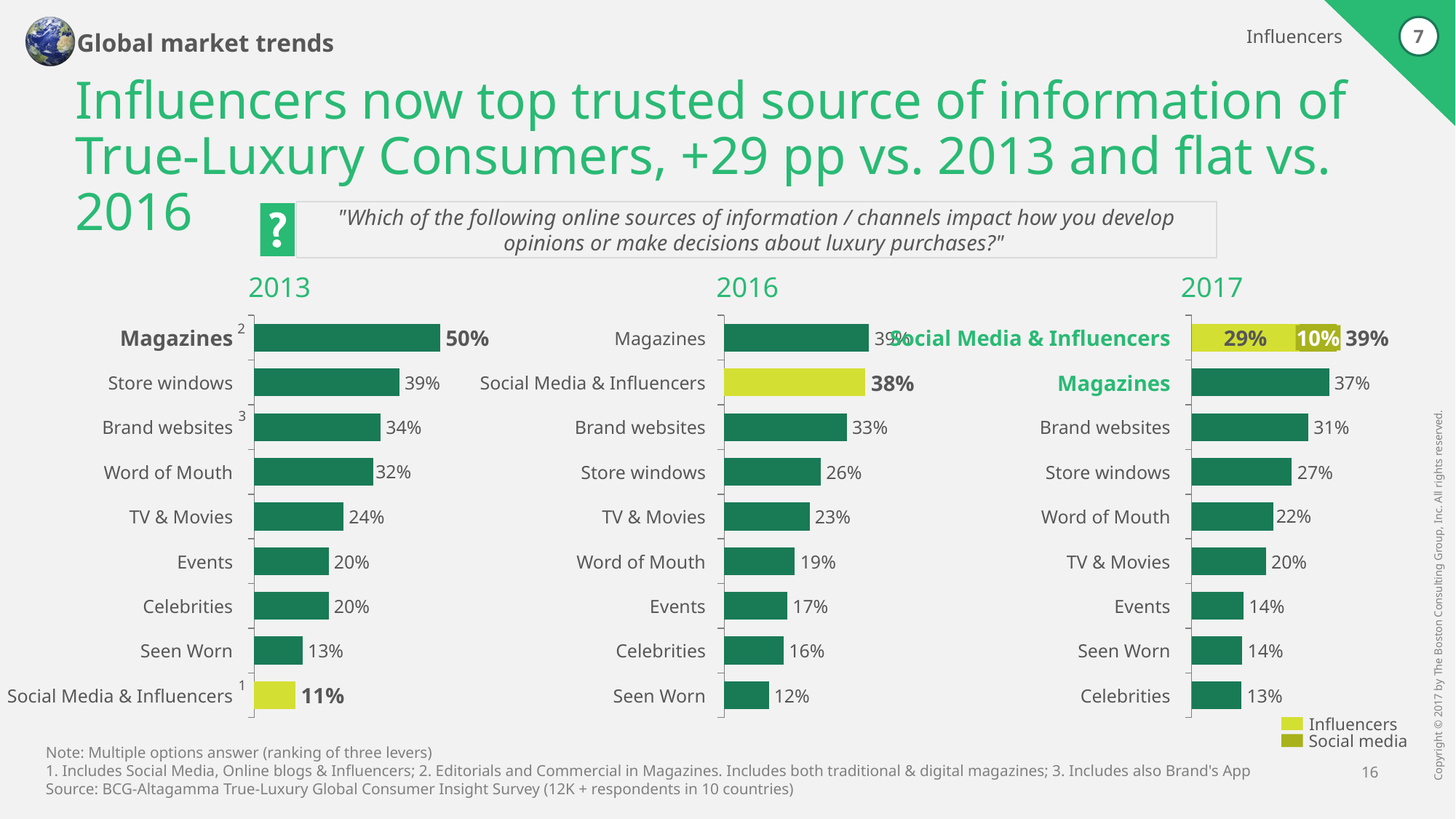
In the 2017 chart, what are the two legend entries? Influencers and Social media In the 2017 chart, what is the value for Magazines? 37% What kind of chart is used for the 2016 data? Bar chart In the 2016 chart, which is larger, Brand websites or Store windows? Brand websites In the 2017 chart, what is the total value for Social Media & Influencers? 39% In the 2017 chart, which category has the lowest value? Celebrities In the 2013 chart, what is the difference between Store windows and Brand websites? 5% How many categories are shown in the 2017 chart? 9 In the 2013 chart, what is the value for Magazines? 50% In the 2013 chart, which category has the highest value? Magazines In the 2016 chart, what is the value for Social Media & Influencers? 38% In the 2013 chart, what is the value for Social Media & Influencers? 11%